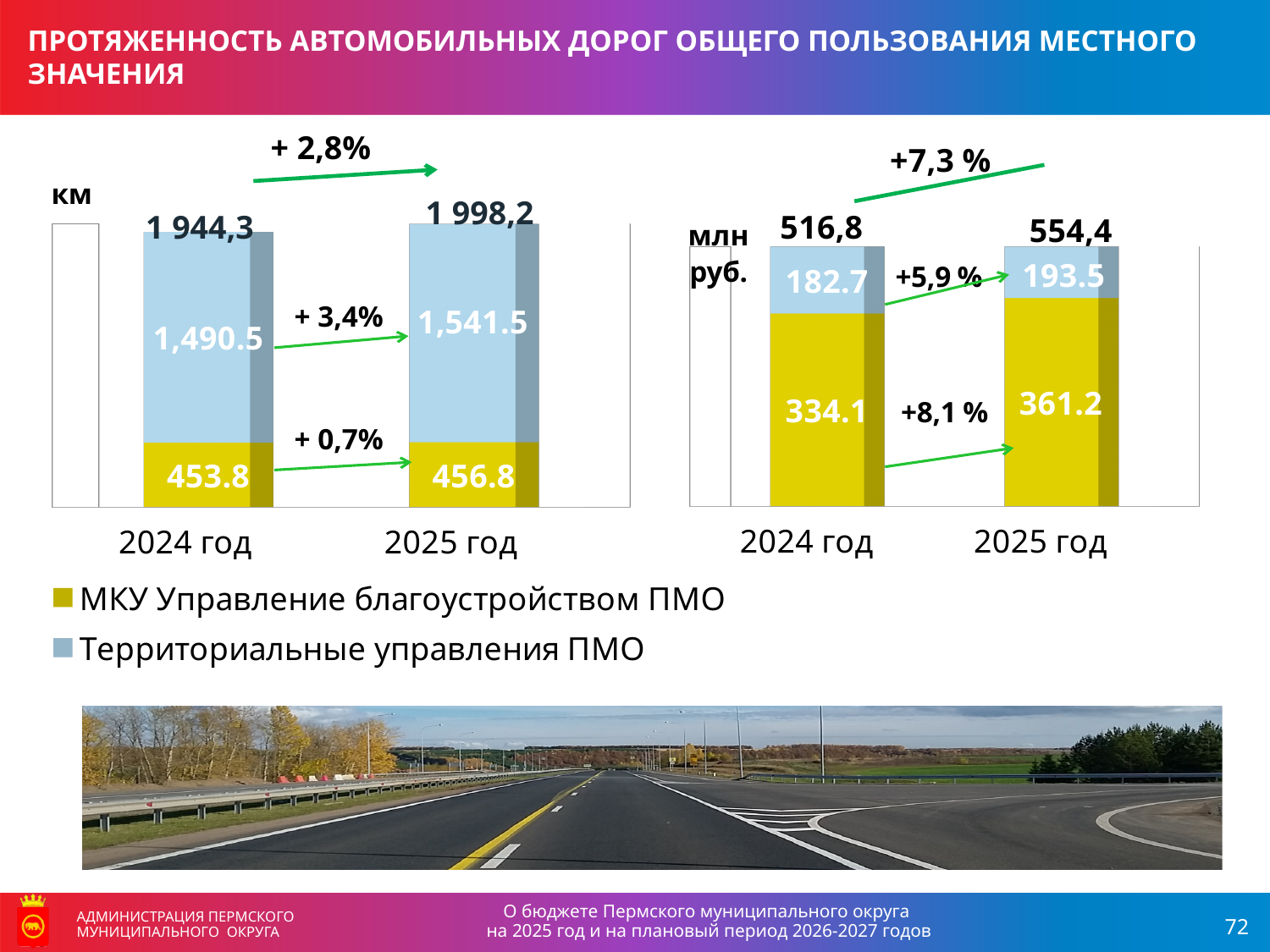
In the left chart (km), what is the value for МКУ Управление благоустройством ПМО in 2024 год? 453.8 In the right chart (млн руб.), what is the total of the stacked bar for 2024 год? 516,8 In the right chart (млн руб.), what is the value for Территориальные управления ПМО in 2024 год? 182.7 How many series does the legend list? 2 In the right chart (млн руб.), what is the difference between the МКУ Управление благоустройством ПМО values for 2025 год and 2024 год? 27.1 In the right chart (млн руб.), what is the value for МКУ Управление благоустройством ПМО in 2025 год? 361.2 In the left chart (km), what is the total of the stacked bar for 2025 год? 1 998,2 In the left chart (km), which year has the larger value for Территориальные управления ПМО, 2024 год or 2025 год? 2025 год In the right chart (млн руб.), what percentage change is shown for the total from 2024 год to 2025 год? +7,3 % What kind of chart is the left chart (km)? Stacked bar chart In the right chart (млн руб.), which series has the larger value in 2024 год? МКУ Управление благоустройством ПМО In the left chart (km), what is the value for Территориальные управления ПМО in 2025 год? 1,541.5